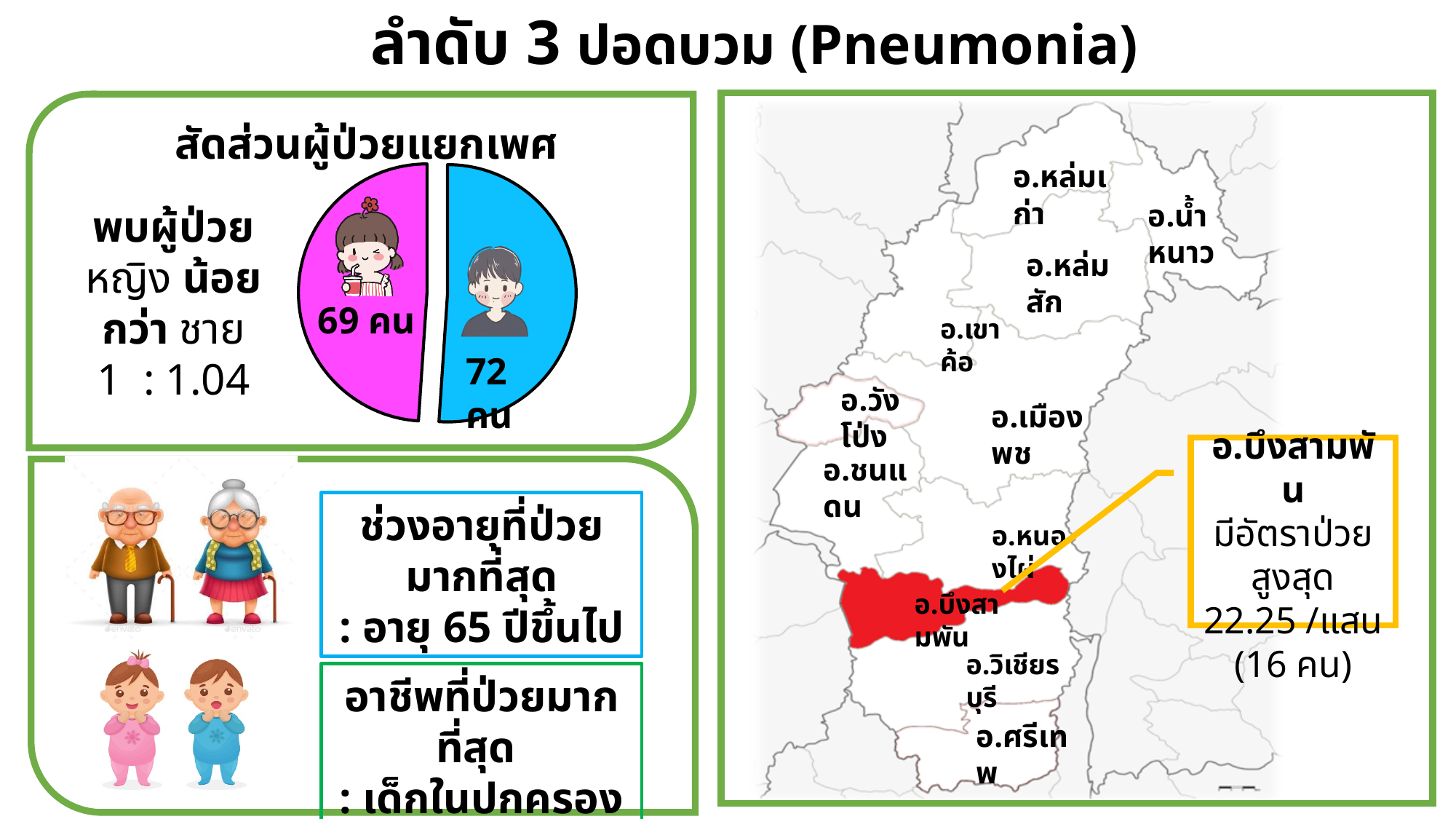
In the pie chart สัดส่วนผู้ป่วยแยกเพศ, what is the difference between the number of male and female patients? 3 คน What is the title of the pie chart on the left of the slide? สัดส่วนผู้ป่วยแยกเพศ In the pie chart สัดส่วนผู้ป่วยแยกเพศ, what colour is the slice for female patients? pink How many slices does the pie chart สัดส่วนผู้ป่วยแยกเพศ have? 2 What kind of chart is shown under the title สัดส่วนผู้ป่วยแยกเพศ? pie chart In the pie chart สัดส่วนผู้ป่วยแยกเพศ, which gender has the smaller number of patients? หญิง (female) In the pie chart สัดส่วนผู้ป่วยแยกเพศ, is the female slice larger or smaller than the male slice? smaller In the pie chart สัดส่วนผู้ป่วยแยกเพศ, how many male patients (ชาย) are shown? 72 คน In the pie chart สัดส่วนผู้ป่วยแยกเพศ, how many female patients (หญิง) are shown? 69 คน In the pie chart สัดส่วนผู้ป่วยแยกเพศ, which gender has the larger number of patients? ชาย (male) What is the total number of patients represented in the pie chart สัดส่วนผู้ป่วยแยกเพศ? 141 คน